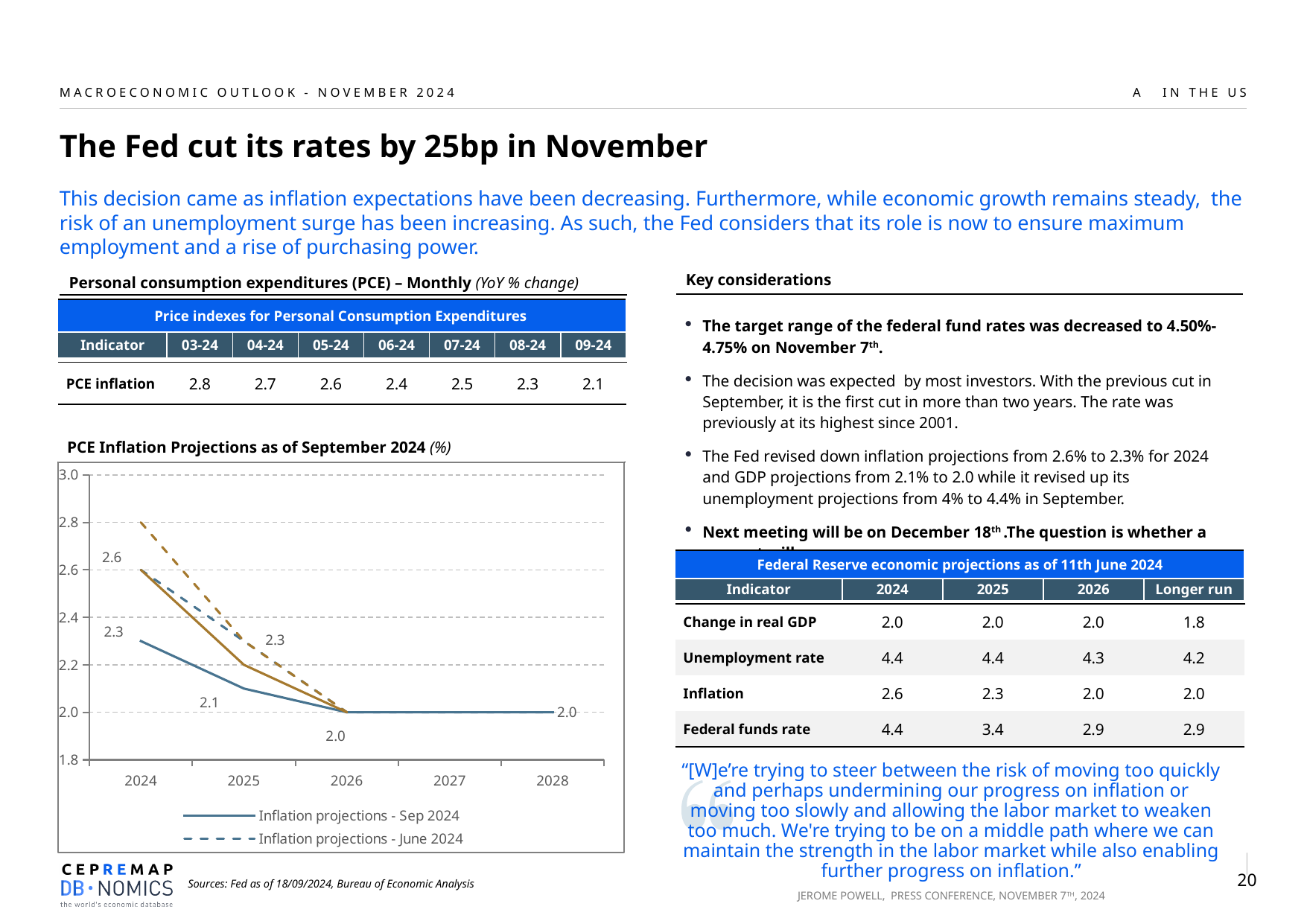
In the PCE Inflation Projections chart, what is the June 2024 inflation projection for 2024? 2.6 In the PCE Inflation Projections chart, what is the Sep 2024 inflation projection for 2024? 2.3 In the PCE Inflation Projections chart, is the Sep 2024 projection for 2024 greater or less than 2.4? less In the PCE Inflation Projections chart, do the Sep 2024 inflation projections rise or fall from 2024 to 2026? fall How many years are shown on the x axis of the PCE Inflation Projections chart? 5 In the PCE Inflation Projections chart, what is the inflation projection for 2028? 2.0 How many series does the legend of the PCE Inflation Projections chart list? 2 In the PCE Inflation Projections chart, what is the difference between the June 2024 and Sep 2024 projections for 2024? 0.3 In the PCE Inflation Projections chart, what is the Sep 2024 inflation projection for 2025? 2.1 What are the two legend entries of the PCE Inflation Projections chart? Inflation projections - Sep 2024; Inflation projections - June 2024 In the PCE Inflation Projections chart, which projection for 2024 is higher: June 2024 or Sep 2024? June 2024 What kind of chart is the 'PCE Inflation Projections as of September 2024' chart? line chart